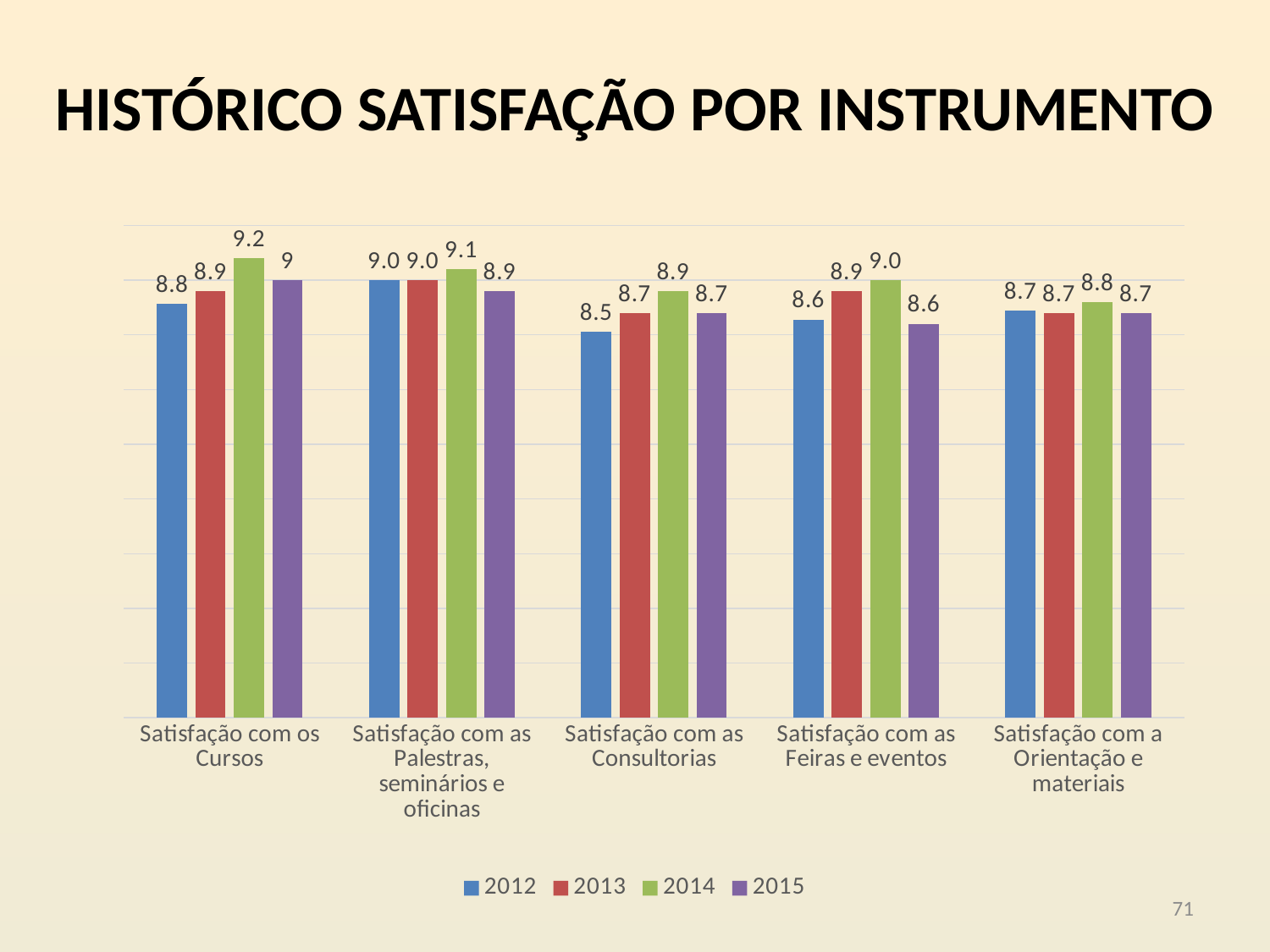
What is the 2014 value for Satisfação com os Cursos? 9.2 What is the difference between the 2014 and 2012 values for Satisfação com as Consultorias? 0.4 How many series does the legend list? 4 What is the 2012 value for Satisfação com as Consultorias? 8.5 Which category has the highest 2014 value? Satisfação com os Cursos How many categories are shown on the x axis? 5 What is the 2013 value for Satisfação com as Palestras, seminários e oficinas? 9.0 What is the 2015 value for Satisfação com as Feiras e eventos? 8.6 What kind of chart is shown on the slide? Bar chart What is the title of the slide? HISTÓRICO SATISFAÇÃO POR INSTRUMENTO Which category has the lowest 2012 value? Satisfação com as Consultorias Which is larger for Satisfação com as Feiras e eventos: the 2013 value or the 2015 value? 2013